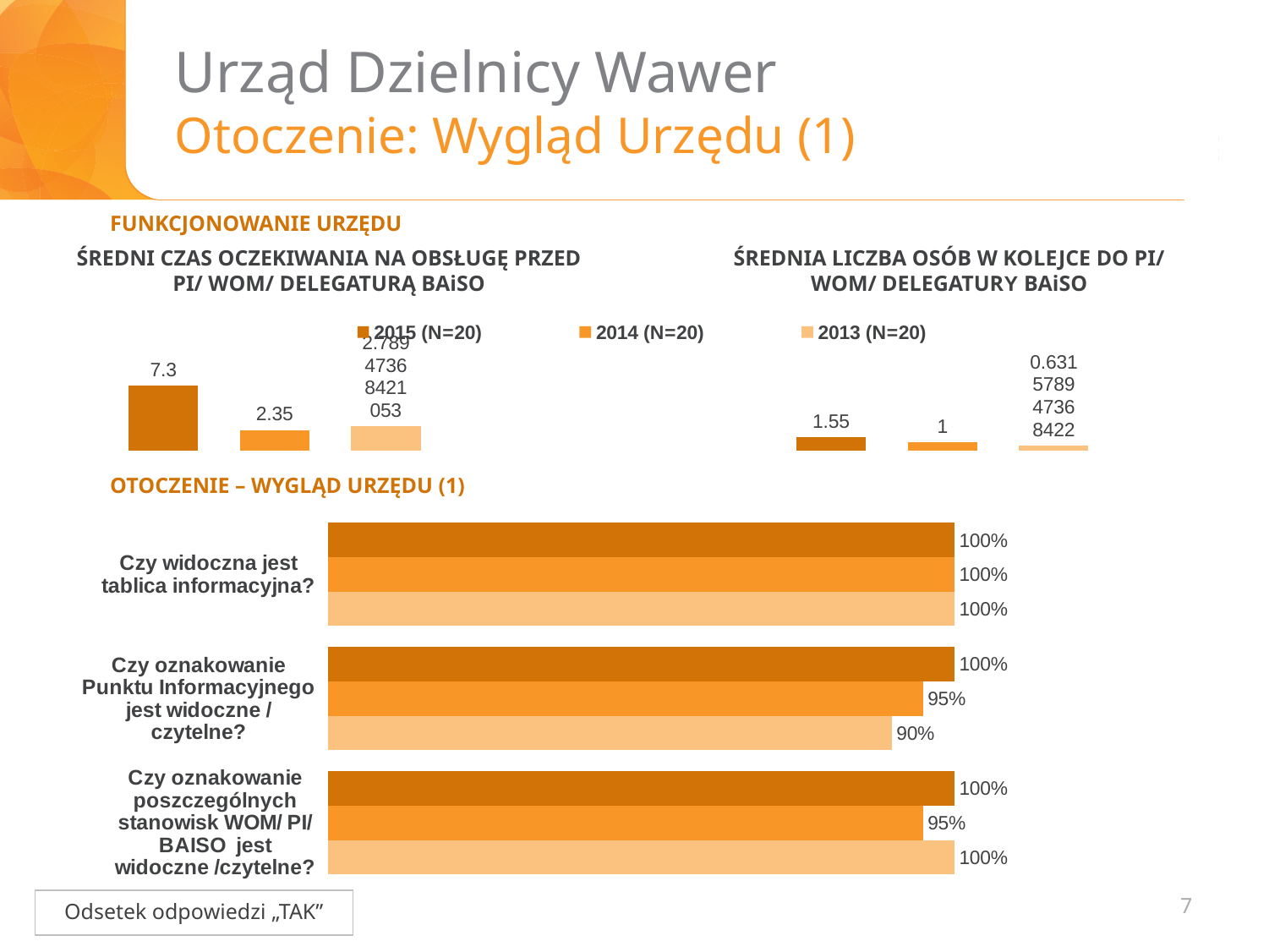
In the chart 'Średni czas oczekiwania na obsługę przed PI/ WOM/ Delegaturą BAiSO', which year has the highest value? 2015 (N=20) How many series does the legend list for the charts in the 'Funkcjonowanie Urzędu' section? 3 In the chart 'Średnia liczba osób w kolejce do PI/ WOM/ Delegatury BAiSO', what is the value for 2015 (N=20)? 1.55 In the chart 'Otoczenie – Wygląd Urzędu (1)', what is the 2014 (N=20) value for 'Czy oznakowanie poszczególnych stanowisk WOM/ PI/ BAISO jest widoczne /czytelne?'? 95% What type of chart is 'Otoczenie – Wygląd Urzędu (1)'? Bar chart In the chart 'Średni czas oczekiwania na obsługę przed PI/ WOM/ Delegaturą BAiSO', what is the value for 2014 (N=20)? 2.35 In the chart 'Otoczenie – Wygląd Urzędu (1)', how many questions (categories) are shown? 3 In the chart 'Otoczenie – Wygląd Urzędu (1)', what is the difference between the 2015 and 2013 values for 'Czy oznakowanie Punktu Informacyjnego jest widoczne / czytelne?'? 10% In the chart 'Średni czas oczekiwania na obsługę przed PI/ WOM/ Delegaturą BAiSO', what is the value for 2015 (N=20)? 7.3 In the chart 'Średnia liczba osób w kolejce do PI/ WOM/ Delegatury BAiSO', which year has the lowest value? 2013 (N=20) In the chart 'Średnia liczba osób w kolejce do PI/ WOM/ Delegatury BAiSO', what is the value for 2014 (N=20)? 1 In the chart 'Otoczenie – Wygląd Urzędu (1)', what is the 2013 (N=20) value for 'Czy oznakowanie Punktu Informacyjnego jest widoczne / czytelne?'? 90%